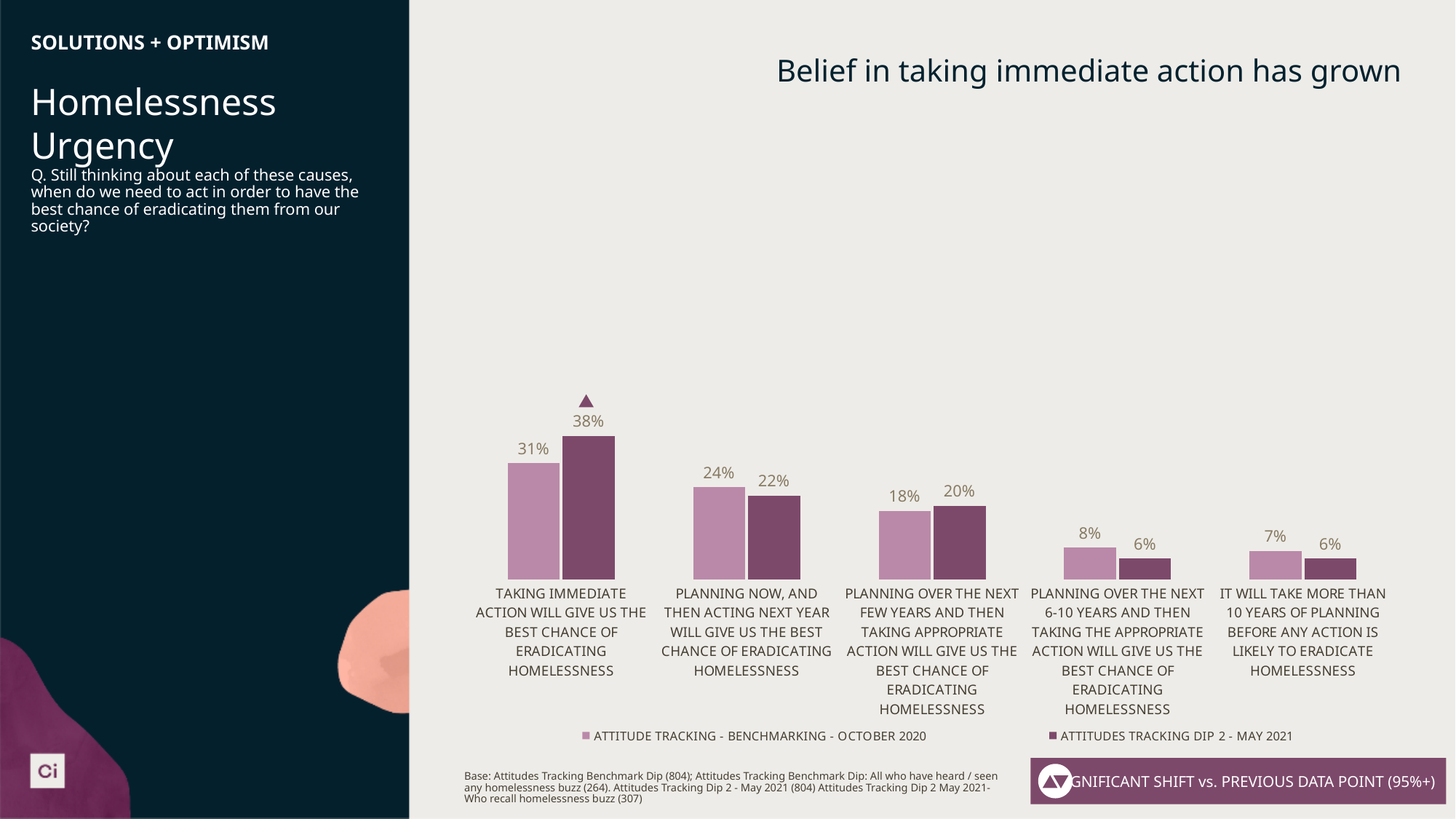
Which category has the highest value in the May 2021 series? Taking immediate action will give us the best chance of eradicating homelessness What is the May 2021 value for 'Planning over the next few years and then taking appropriate action will give us the best chance of eradicating homelessness'? 20% What is the difference between the May 2021 and October 2020 values for 'Taking immediate action will give us the best chance of eradicating homelessness'? 7% Which category has the lowest value in the October 2020 series? It will take more than 10 years of planning before any action is likely to eradicate homelessness What type of chart is shown on the slide? Bar chart What is the value for 'Planning now, and then acting next year will give us the best chance of eradicating homelessness' in the Attitude Tracking - Benchmarking - October 2020 series? 24% What is the title of the chart? Belief in taking immediate action has grown How many series does the legend list? 2 How many categories are shown on the x axis of the chart? 5 What is the October 2020 value for 'It will take more than 10 years of planning before any action is likely to eradicate homelessness'? 7% For 'Planning over the next 6-10 years and then taking the appropriate action', which series has the larger value: October 2020 or May 2021? October 2020 What is the value for 'Taking immediate action will give us the best chance of eradicating homelessness' in the Attitudes Tracking Dip 2 - May 2021 series? 38%